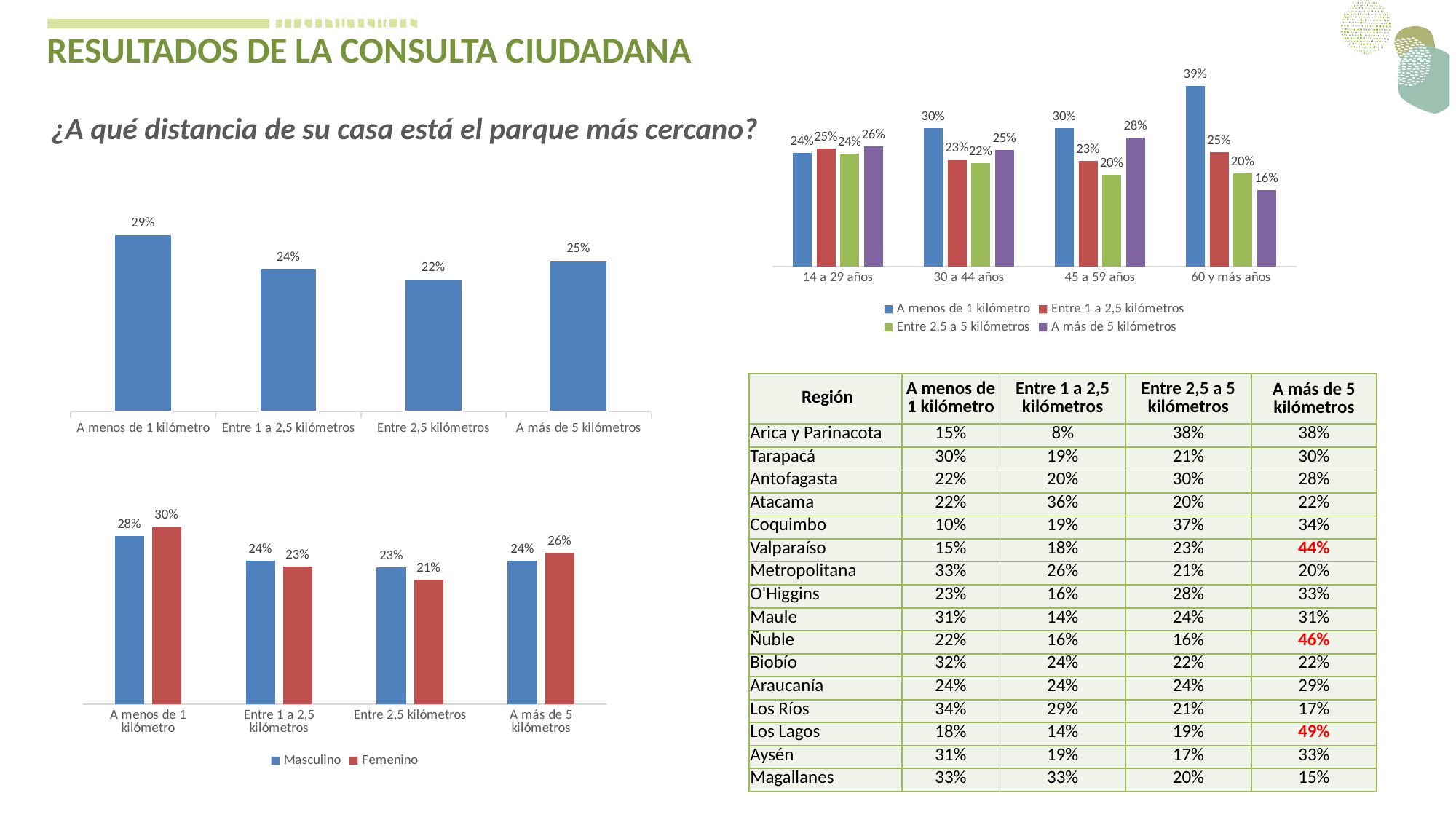
In the top-right chart, what is the value of 'A menos de 1 kilómetro' for '60 y más años'? 39% In the top-left bar chart, what is the value for 'A menos de 1 kilómetro'? 29% How many categories are shown in the top-left bar chart? 4 What type of chart is the top-right chart? Bar chart In the bottom-left chart, what is the Femenino value for 'A menos de 1 kilómetro'? 30% In the top-left bar chart, what is the difference between 'A menos de 1 kilómetro' and 'A más de 5 kilómetros'? 4% In the bottom-left chart, which is larger for 'Entre 2,5 kilómetros': Masculino or Femenino? Masculino In the top-right chart, which age group has the lowest value for 'A más de 5 kilómetros'? 60 y más años In the top-left bar chart, which category has the lowest value? Entre 2,5 kilómetros How many series does the legend of the top-right chart list? 4 In the bottom-left chart, what is the difference between Femenino and Masculino for 'A más de 5 kilómetros'? 2% How many series does the legend of the bottom-left chart list? 2